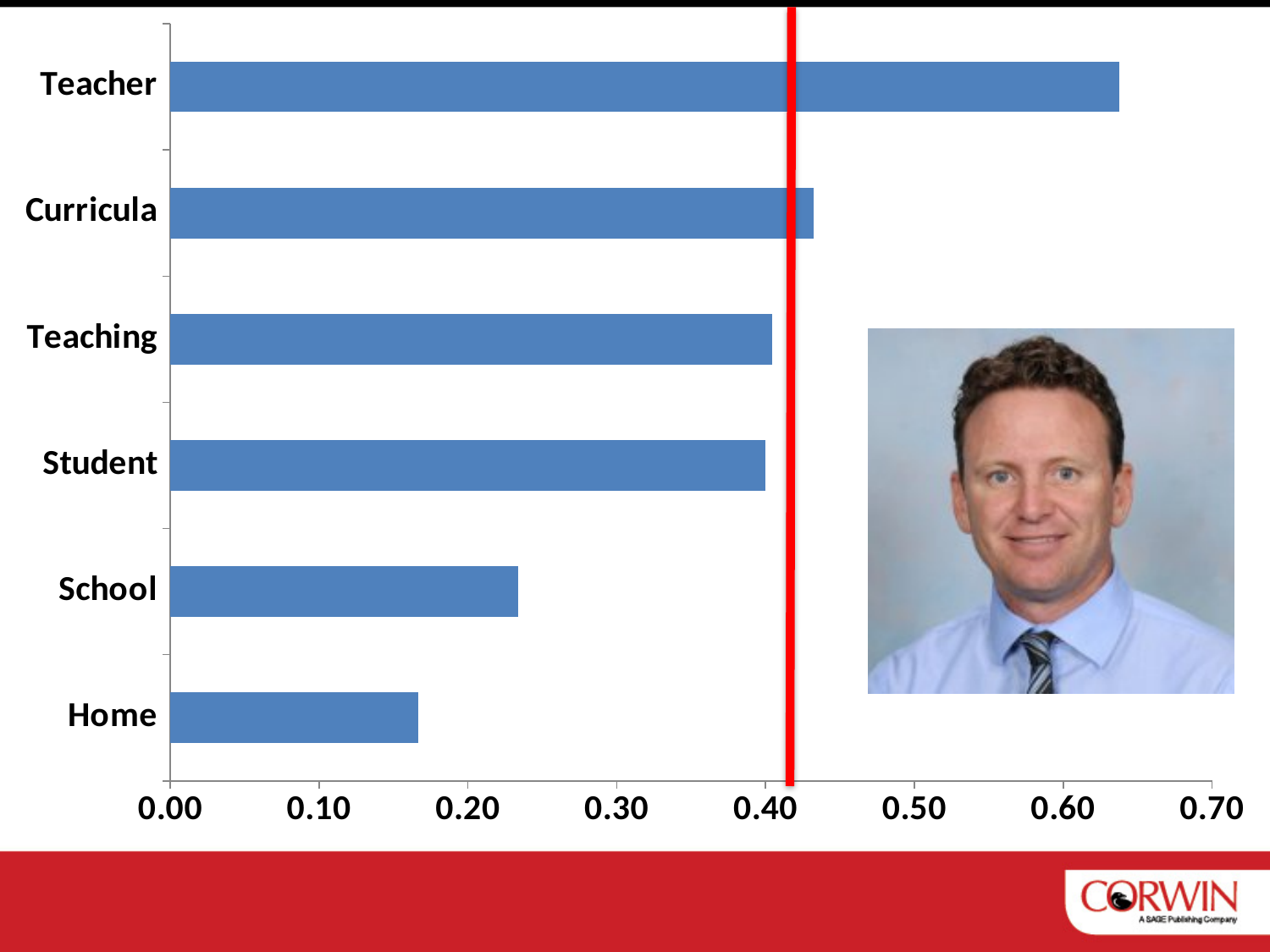
What kind of chart is shown on the slide? bar chart Is the value for Teacher greater or less than 0.60? greater How many categories are plotted in the bar chart? 6 What colour are the bars in the chart? blue Is the value for School greater or less than 0.20? greater Which has a larger value, School or Home? School Which category has the highest value in the bar chart? Teacher Is the value for Student greater or less than 0.50? less Which category has the lowest value in the bar chart? Home Which has a larger value, Teacher or Curricula? Teacher